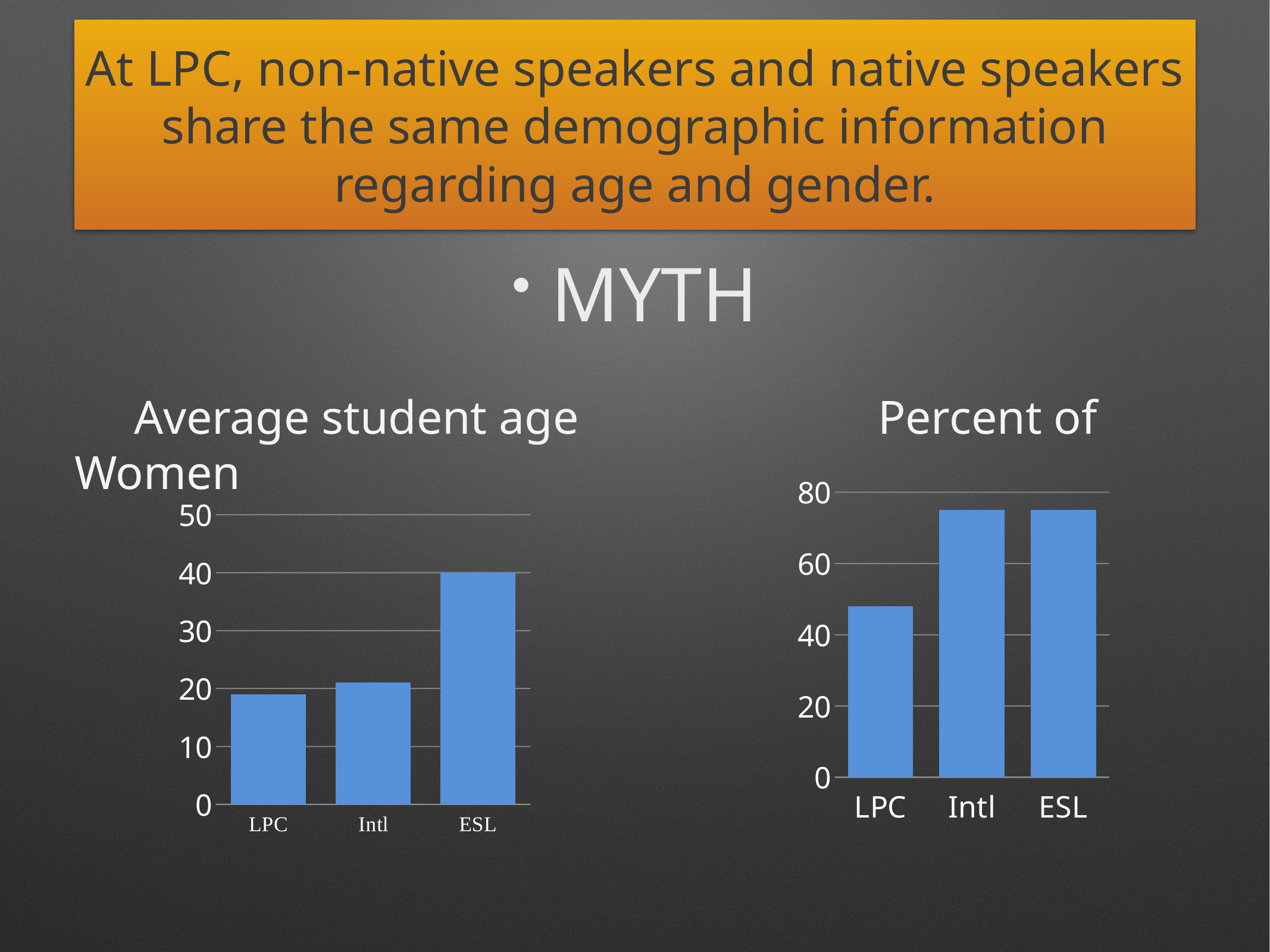
What kind of chart is the Average student age chart? bar chart In the Percent of Women chart, is the value for Intl greater or less than 60? greater In the Percent of Women chart, which is larger, the value for LPC or the value for ESL? ESL In the Average student age chart, what is the value for ESL? 40 In the Percent of Women chart, which category has the lowest value? LPC In the Average student age chart, which category has the lowest value? LPC How many categories are shown in the Average student age chart? 3 In the Percent of Women chart, is the value for LPC greater or less than 40? greater In the Average student age chart, do the values rise or fall from LPC to ESL? rise In the Average student age chart, which category has the highest value? ESL